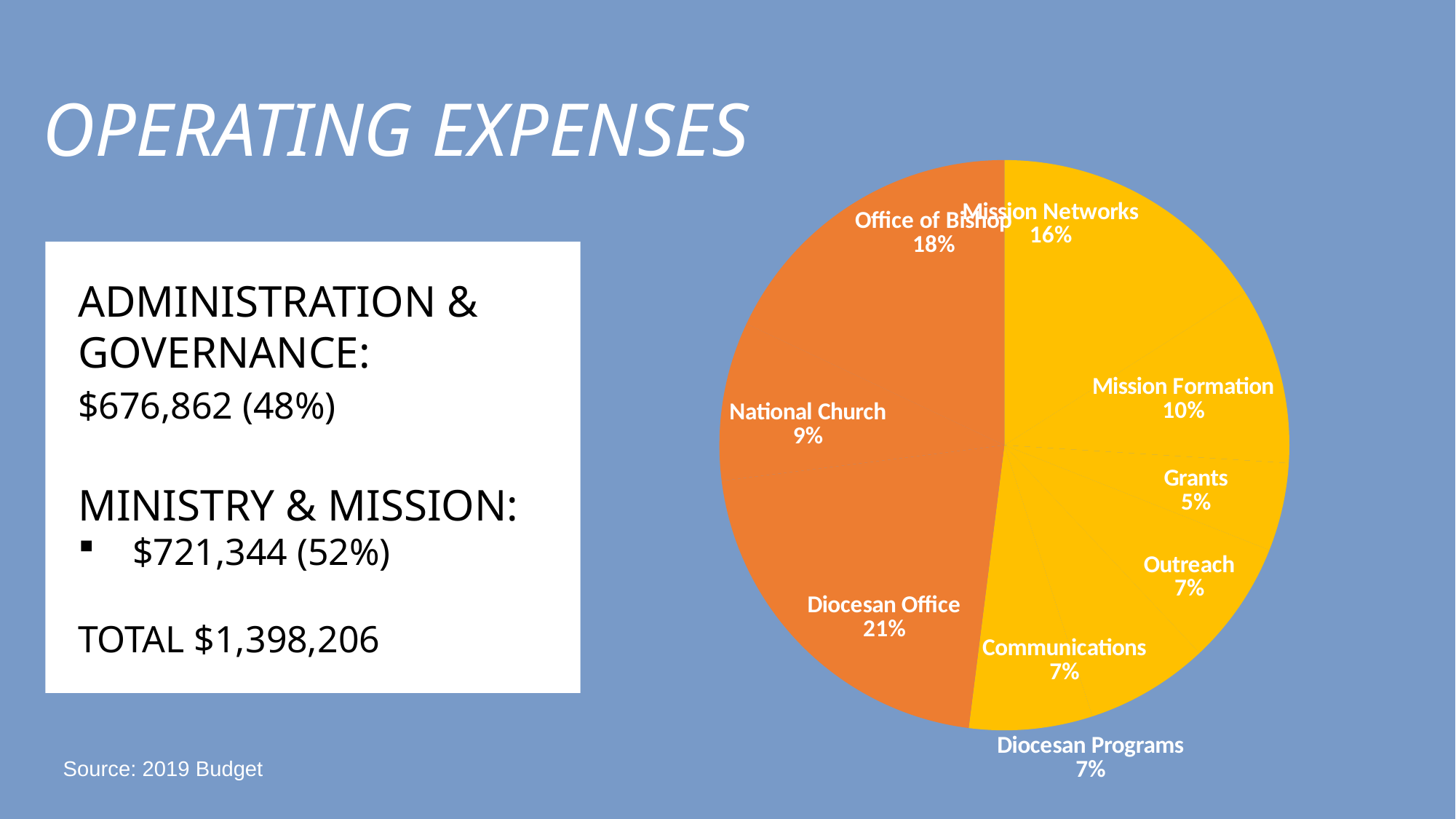
What kind of chart is shown on the slide? pie chart Which is larger, Mission Networks or Office of Bishop? Office of Bishop What share of operating expenses does Diocesan Office account for? 21% What percentage is shown for National Church? 9% Which slice of the pie chart is the smallest? Grants What is the difference in percentage points between Office of Bishop and Mission Formation? 8 What percentage is shown for Mission Networks? 16% Which slice of the pie chart is the largest? Diocesan Office What is the combined share of Outreach, Communications and Diocesan Programs? 21% What percentage is shown for Grants? 5% What colour are the Office of Bishop, National Church and Diocesan Office slices? orange How many slices does the pie chart have? 9